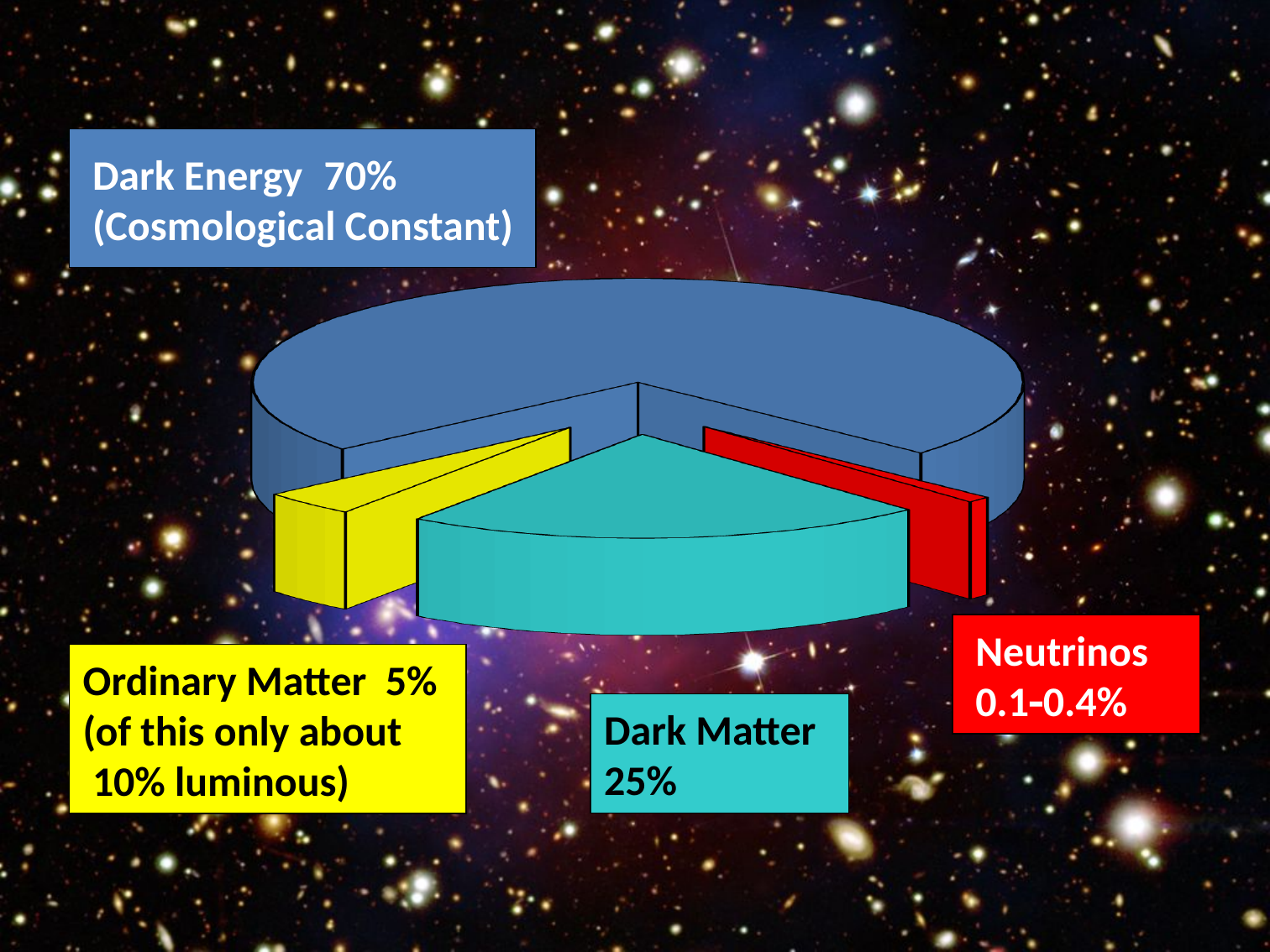
What colour is the Neutrinos slice? red What is the difference between the Dark Energy share and the Dark Matter share? 45% How many slices does the pie chart have? 4 What share of the pie does Dark Matter account for? 25% What colour is the Dark Matter slice? cyan What value is given for Neutrinos? 0.1-0.4% What share of the pie does Dark Energy account for? 70% What kind of chart is shown on the slide? pie chart What share of the pie does Ordinary Matter account for? 5% Which slice of the pie is the smallest? Neutrinos Which is larger, the Dark Matter share or the Ordinary Matter share? Dark Matter Which slice of the pie is the largest? Dark Energy